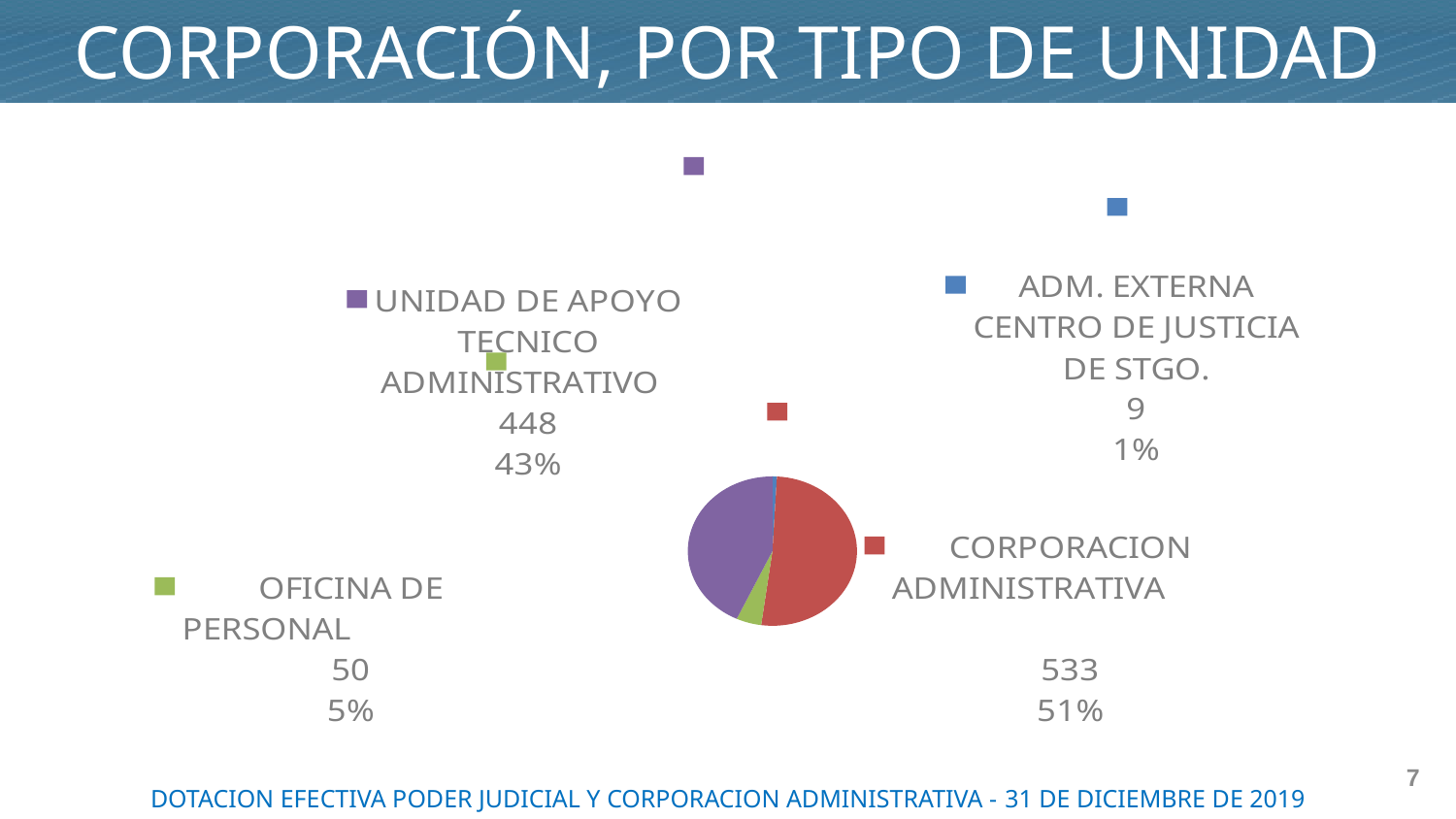
Which is larger, the value for OFICINA DE PERSONAL or the value for ADM. EXTERNA CENTRO DE JUSTICIA DE STGO.? OFICINA DE PERSONAL What is the difference between the values for CORPORACION ADMINISTRATIVA and UNIDAD DE APOYO TECNICO ADMINISTRATIVO? 85 Which category has the largest slice of the pie? CORPORACION ADMINISTRATIVA Which category has the smallest slice of the pie? ADM. EXTERNA CENTRO DE JUSTICIA DE STGO. What share of the pie does CORPORACION ADMINISTRATIVA represent? 51% How many slices does the pie chart have? 4 What is the value for OFICINA DE PERSONAL? 50 What is the value for CORPORACION ADMINISTRATIVA? 533 What share of the pie does OFICINA DE PERSONAL represent? 5% What is the value for ADM. EXTERNA CENTRO DE JUSTICIA DE STGO.? 9 What kind of chart is shown on the slide? Pie chart What is the value for UNIDAD DE APOYO TECNICO ADMINISTRATIVO? 448